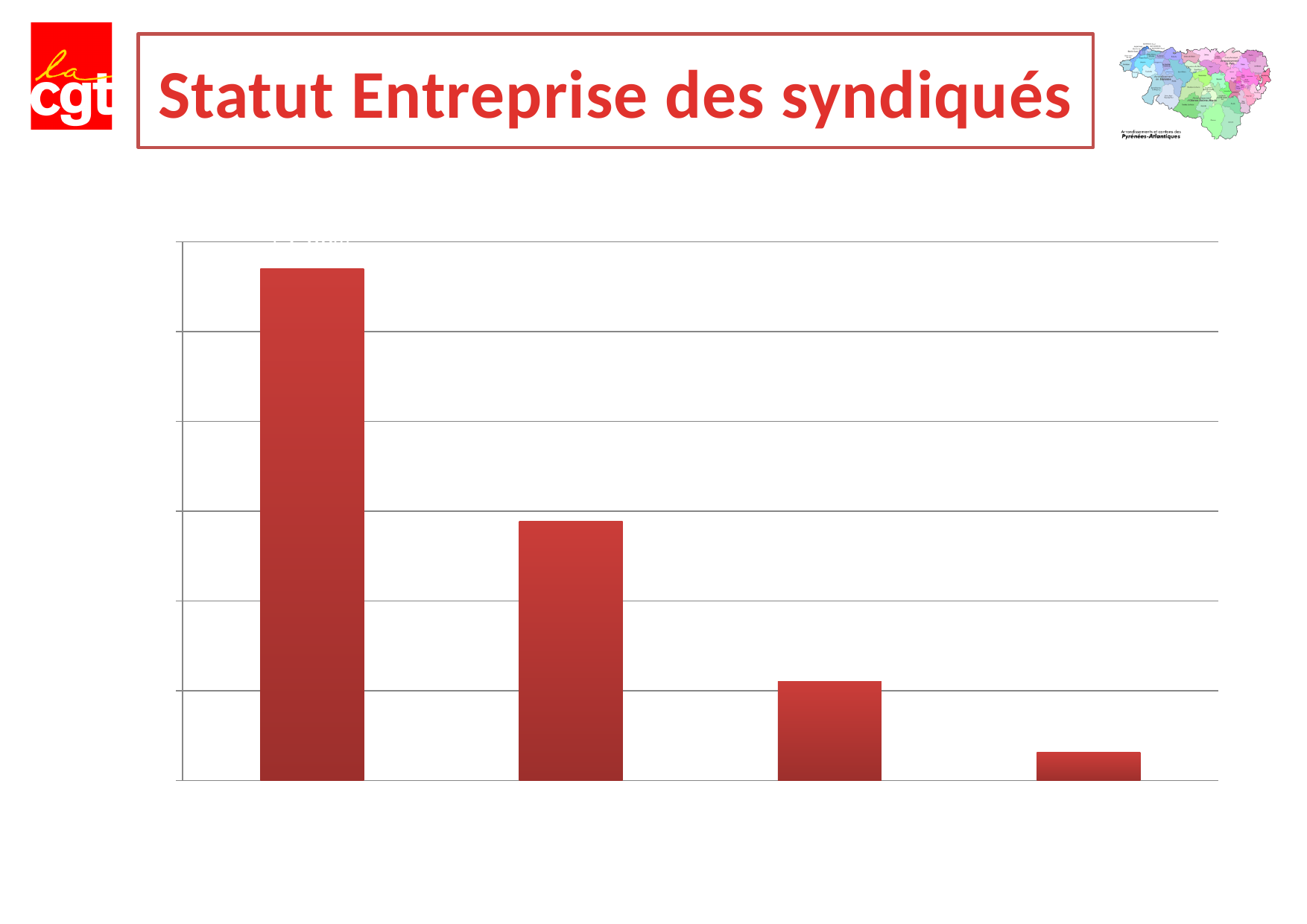
Which bar is the tallest in the chart? the first (leftmost) bar Which is taller, the first bar or the second bar? the first bar What kind of chart is shown on the slide? bar chart What colour are the bars in the chart? red Do the bar values rise or fall from left to right across the chart? fall Which is taller, the third bar or the fourth bar? the third bar How many bars does the chart contain? 4 Which bar is the shortest in the chart? the fourth (rightmost) bar What is the title shown above the chart on the slide? Statut Entreprise des syndiqués Which is taller, the second bar or the third bar? the second bar